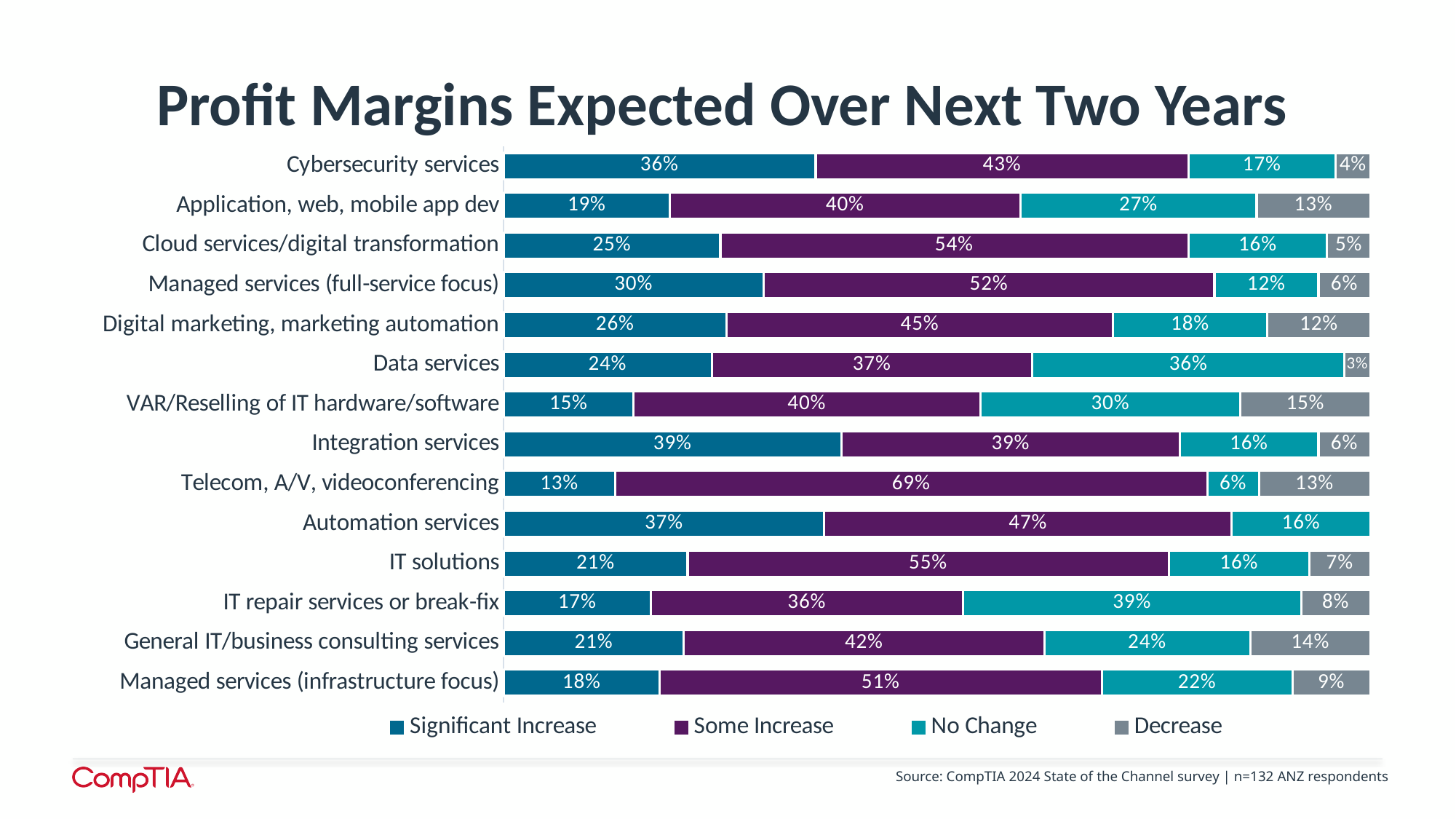
What is the title of the chart? Profit Margins Expected Over Next Two Years How many series does the legend list? 4 Which category has the lowest Significant Increase percentage? Telecom, A/V, videoconferencing What is the Some Increase value for Telecom, A/V, videoconferencing? 69% How many service categories are shown in the chart? 14 Which category has the highest Significant Increase percentage? Integration services For Cybersecurity services, how many percentage points larger is the Some Increase value than the Significant Increase value? 7 percentage points What percentage of respondents expect a Significant Increase in profit margins for Cybersecurity services? 36% What is the Decrease value for VAR/Reselling of IT hardware/software? 15% Which has a larger No Change value: Data services or IT repair services or break-fix? IT repair services or break-fix Which category has the highest Some Increase percentage? Telecom, A/V, videoconferencing What type of chart is shown on the slide? Stacked bar chart